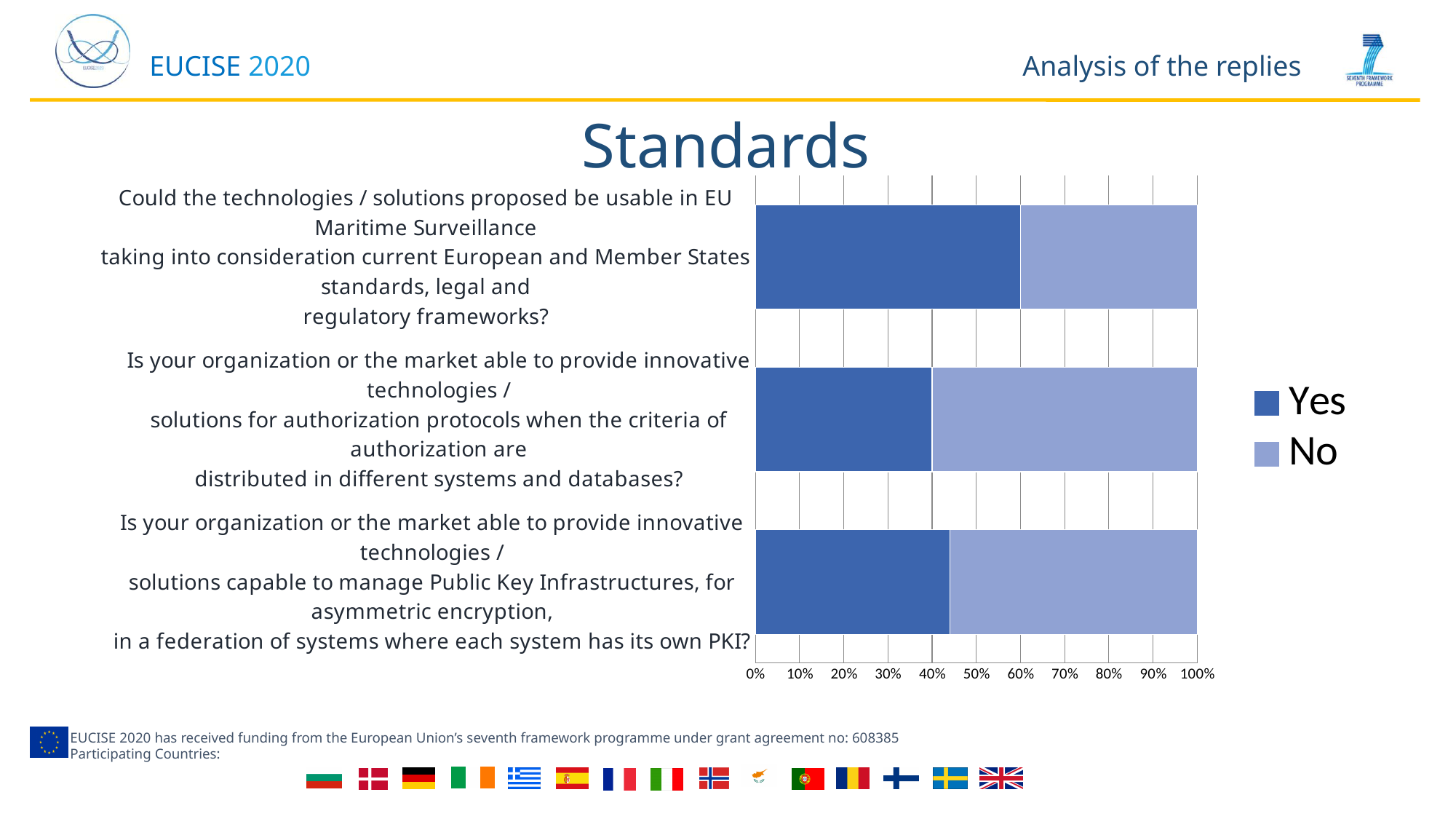
What kind of chart is shown on the slide? bar chart For the question about authorization protocols distributed in different systems and databases, which is larger: the Yes share or the No share? No What are the two entries in the chart legend? Yes and No Is the Yes share for the question about managing Public Key Infrastructures in a federation of systems greater or less than 50%? less How many series does the legend list? 2 Is the Yes share for the question about technologies being usable in EU Maritime Surveillance greater or less than 50%? greater Which question received the highest share of Yes replies? Could the technologies / solutions proposed be usable in EU Maritime Surveillance taking into consideration current European and Member States standards, legal and regulatory frameworks? How many questions (categories) are plotted in the chart? 3 What is the title of the chart? Standards Which has the larger Yes share: the question about usability in EU Maritime Surveillance or the question about authorization protocols? the question about usability in EU Maritime Surveillance Is the Yes share for the question about authorization protocols with criteria distributed in different systems and databases greater or less than 50%? less For the question about technologies being usable in EU Maritime Surveillance, which is larger: the Yes share or the No share? Yes